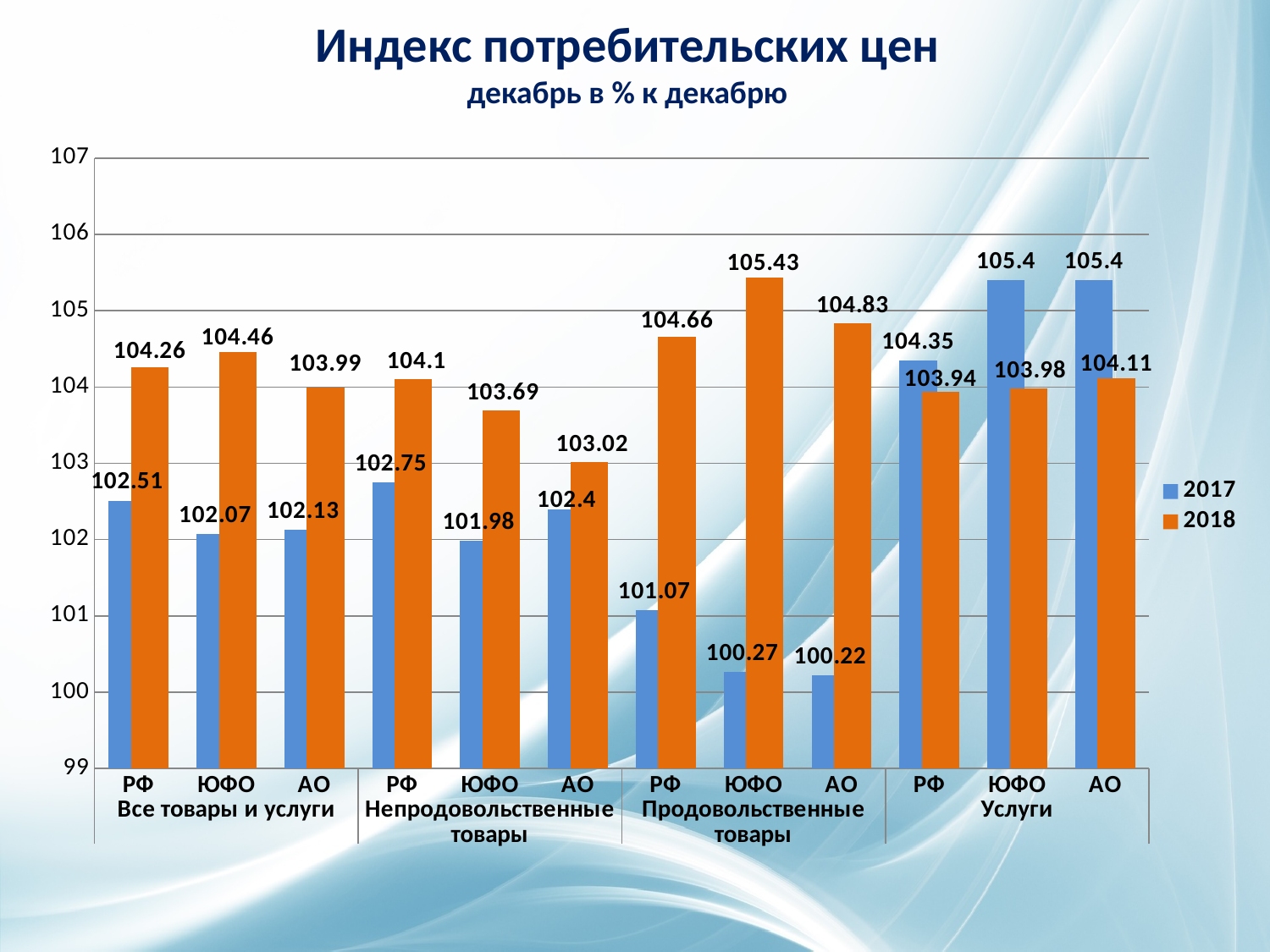
How many categories (bar pairs) are shown on the x axis? 12 What is the title of the chart? Индекс потребительских цен Is the 2017 value for РФ in the Непродовольственные товары group greater or less than 103? less Which category has the highest 2018 value? ЮФО, Продовольственные товары What is the 2018 value for АО in the Услуги group? 104.11 What is the 2017 value for ЮФО in the Продовольственные товары group? 100.27 How many series does the legend list? 2 What is the difference between the 2018 and 2017 values for РФ in the Продовольственные товары group? 3.59 What kind of chart is shown on the slide? Bar chart Which category has the lowest 2017 value? АО, Продовольственные товары Which is larger for ЮФО in the Услуги group: the 2017 value or the 2018 value? 2017 What is the 2018 value for РФ in the Все товары и услуги group? 104.26